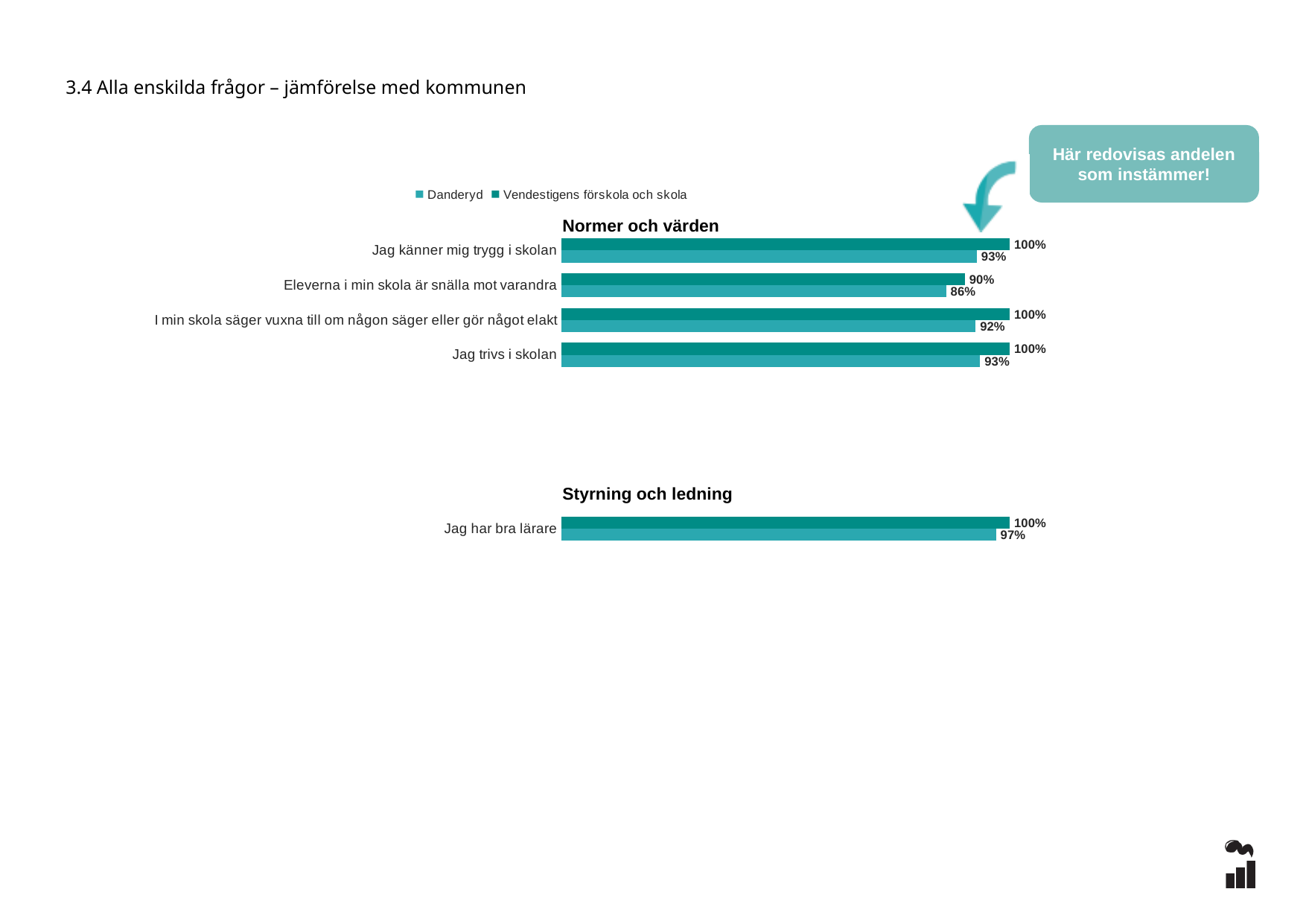
In the 'Styrning och ledning' chart, what is the value for Danderyd for 'Jag har bra lärare'? 97% In the 'Normer och värden' chart, which is larger for 'Eleverna i min skola är snälla mot varandra': Danderyd or Vendestigens förskola och skola? Vendestigens förskola och skola In the 'Normer och värden' chart, which category has the lowest value for Vendestigens förskola och skola? Eleverna i min skola är snälla mot varandra In the 'Normer och värden' chart, what is the value for Danderyd for 'I min skola säger vuxna till om någon säger eller gör något elakt'? 92% How many series does the legend list? 2 In the 'Normer och värden' chart, what is the value for Vendestigens förskola och skola for 'Jag känner mig trygg i skolan'? 100% In the 'Normer och värden' chart, what is the value for Danderyd for 'Eleverna i min skola är snälla mot varandra'? 86% In the 'Styrning och ledning' chart, what is the difference between Vendestigens förskola och skola and Danderyd for 'Jag har bra lärare'? 3 percentage points In the 'Normer och värden' chart, which category has the lowest value for Danderyd? Eleverna i min skola är snälla mot varandra How many categories does the 'Normer och värden' chart show? 4 In the 'Normer och värden' chart, what is the difference between Vendestigens förskola och skola and Danderyd for 'Jag trivs i skolan'? 7 percentage points What kind of chart is the 'Styrning och ledning' chart? Bar chart